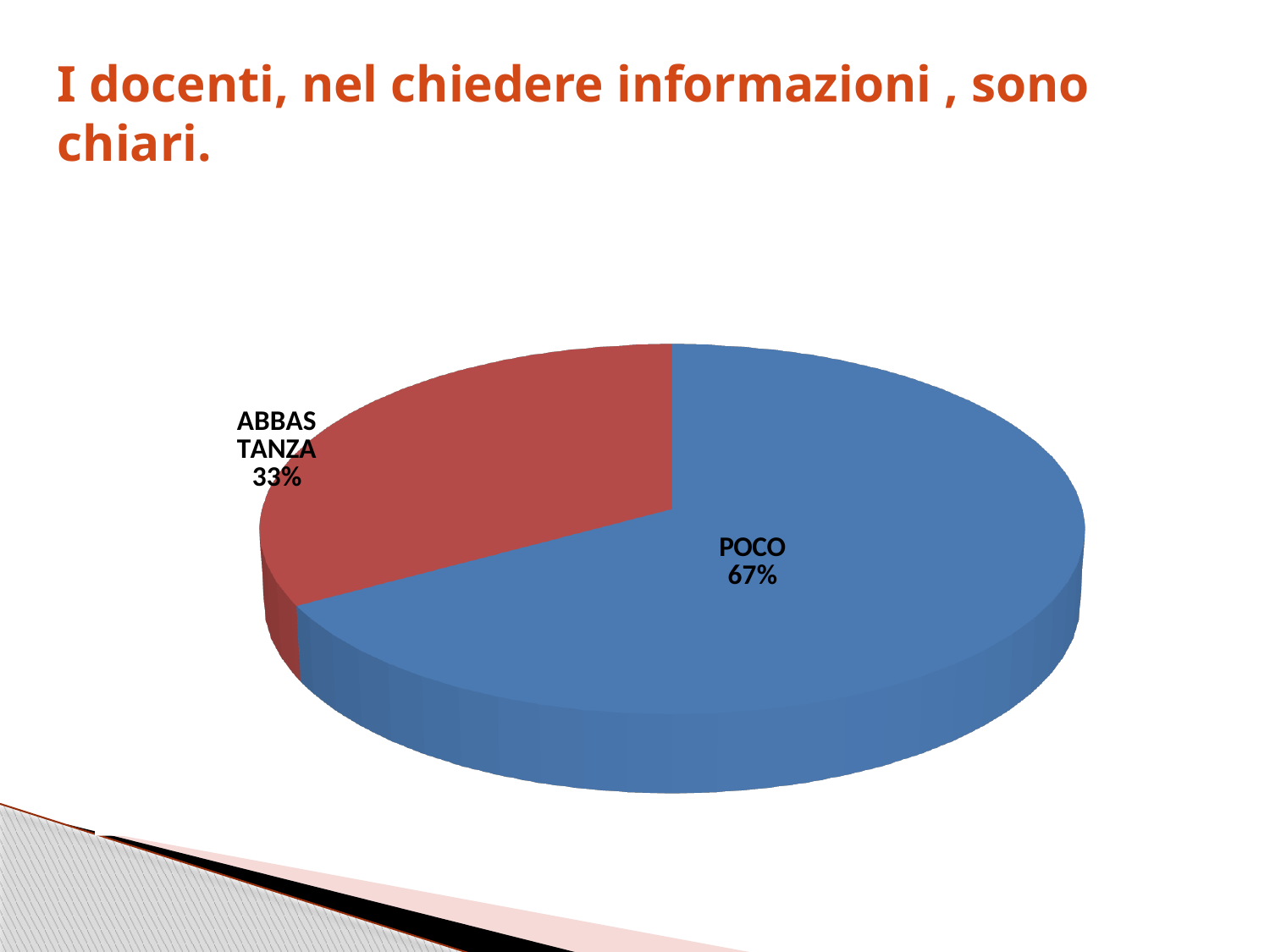
What is the title of the slide containing the pie chart? I docenti, nel chiedere informazioni , sono chiari. What share of the pie does POCO represent? 67% What kind of chart is shown on the slide? pie chart What colour is the POCO slice? blue How many slices does the pie chart have? 2 What share of the pie does ABBASTANZA represent? 33% Which slice of the pie is the smallest? ABBASTANZA Is the share for POCO greater or less than 50%? greater What is the difference in percentage points between the POCO and ABBASTANZA slices? 34 Which is larger, the POCO slice or the ABBASTANZA slice? POCO Which slice of the pie is the largest? POCO